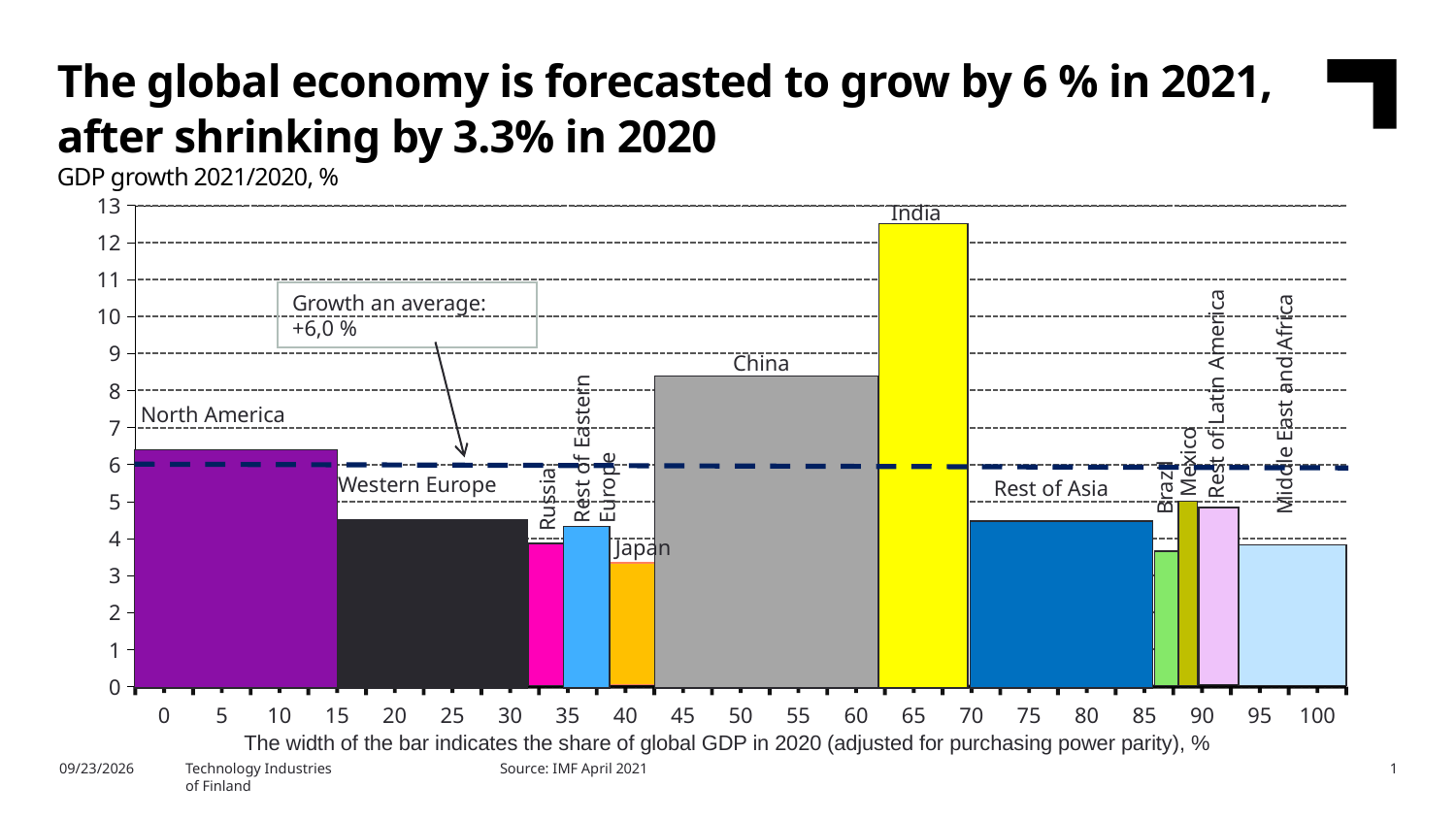
What kind of chart is shown on the slide? Bar chart Is the value for North America greater or less than 6? greater Is the value for Japan greater or less than 4? less Is the value for China greater or less than 8? greater What average growth does the dashed line in the chart represent? +6,0 % Which has a higher GDP growth forecast, China or North America? China How many regions are shown as bars in the chart? 12 Which region has the lowest GDP growth forecast in the chart? Japan Which region has the highest GDP growth forecast in the chart? India Which has a higher GDP growth forecast, Rest of Asia or India? India